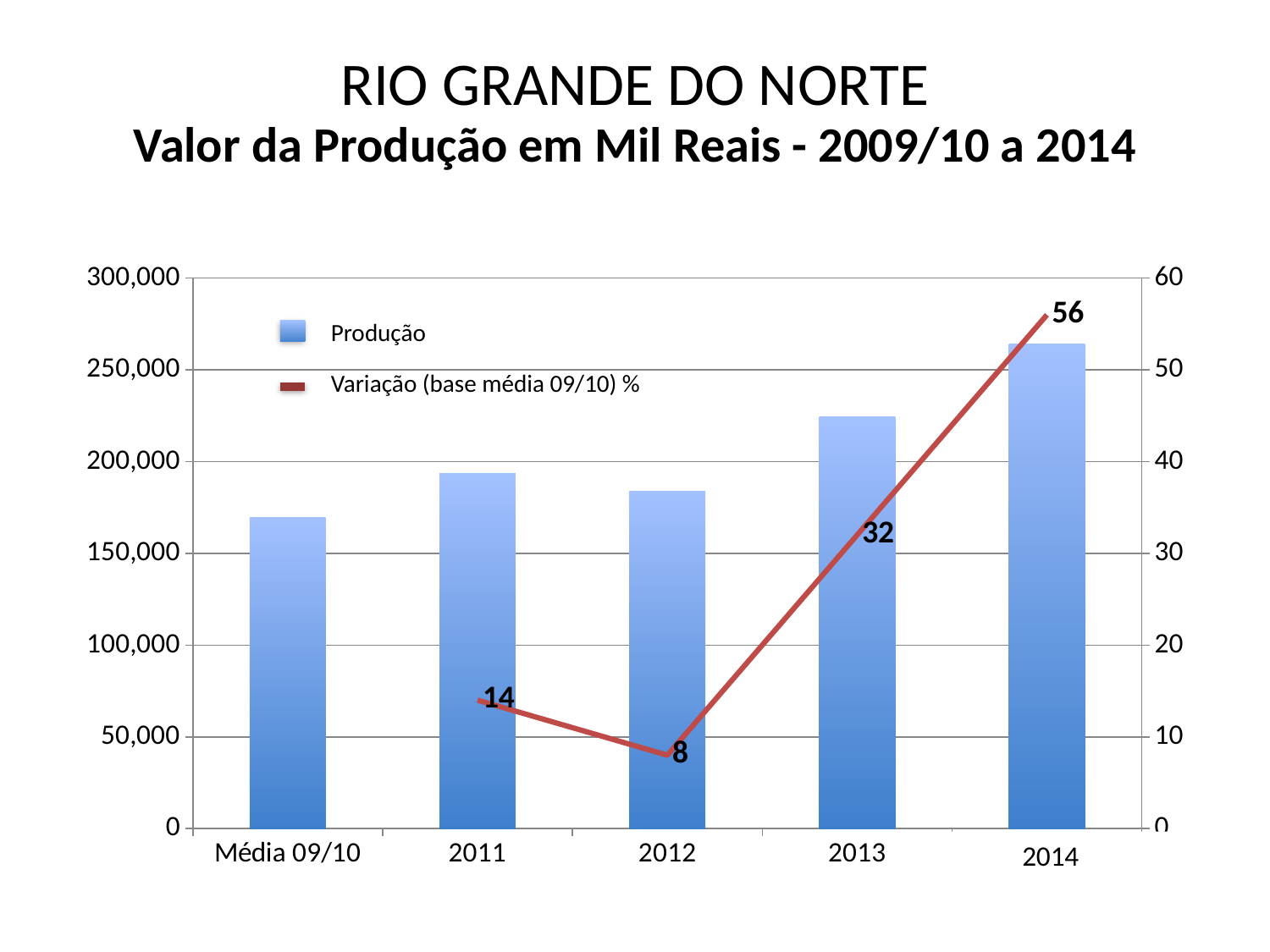
Is the Produção value for 2013 greater or less than 200,000? greater How many categories are shown on the x axis? 5 What is the difference between the Variação (base média 09/10) % for 2014 and for 2013? 24 Which year has the lowest Variação (base média 09/10) %? 2012 What kind of chart is this? Combined bar and line chart What is the value of Variação (base média 09/10) % for 2014? 56 Is the Produção value for Média 09/10 greater or less than 200,000? less What is the value of Variação (base média 09/10) % for 2012? 8 Which year has the highest Variação (base média 09/10) %? 2014 What is the value of Variação (base média 09/10) % for 2011? 14 Is the Produção bar for 2014 taller than the Produção bar for Média 09/10? Yes How many series does the legend list? 2